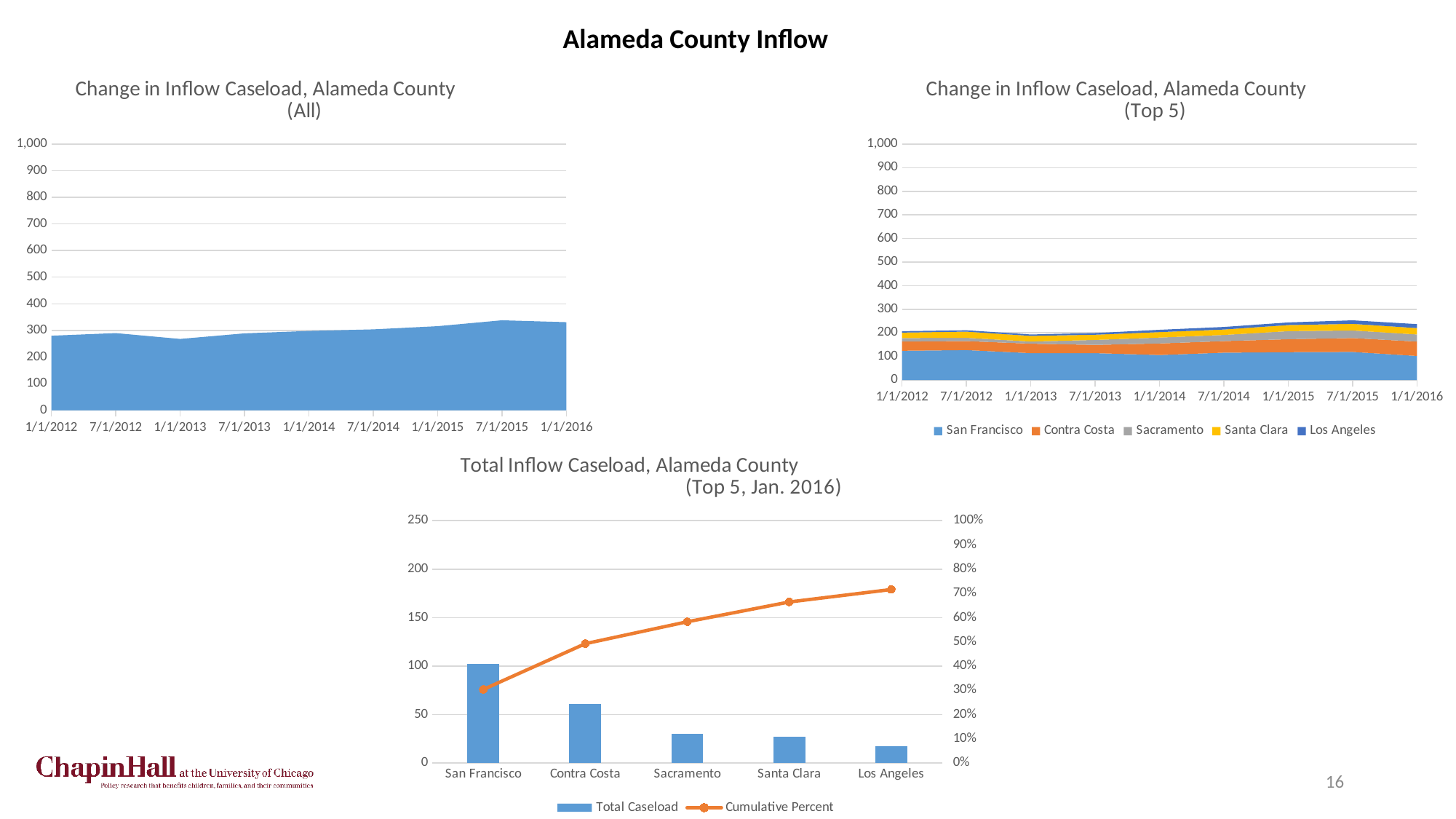
In the 'Total Inflow Caseload, Alameda County (Top 5, Jan. 2016)' chart, is the Cumulative Percent at Los Angeles greater or less than 60%? greater Which series are listed in the legend of the 'Change in Inflow Caseload, Alameda County (Top 5)' chart? San Francisco, Contra Costa, Sacramento, Santa Clara, Los Angeles In the 'Change in Inflow Caseload, Alameda County (All)' chart, is the value at 1/1/2013 greater or less than 300? less In the 'Change in Inflow Caseload, Alameda County (All)' chart, is the value at 1/1/2016 greater or less than 300? greater In the 'Total Inflow Caseload, Alameda County (Top 5, Jan. 2016)' chart, which category has the highest Total Caseload bar? San Francisco How many series does the legend of the 'Change in Inflow Caseload, Alameda County (Top 5)' chart list? 5 How many categories are shown on the x axis of the 'Total Inflow Caseload, Alameda County (Top 5, Jan. 2016)' chart? 5 What kind of chart is the 'Change in Inflow Caseload, Alameda County (All)' chart? area chart In the 'Total Inflow Caseload, Alameda County (Top 5, Jan. 2016)' chart, which category has the lowest Total Caseload bar? Los Angeles In the 'Total Inflow Caseload, Alameda County (Top 5, Jan. 2016)' chart, which has a larger Total Caseload, Contra Costa or Sacramento? Contra Costa